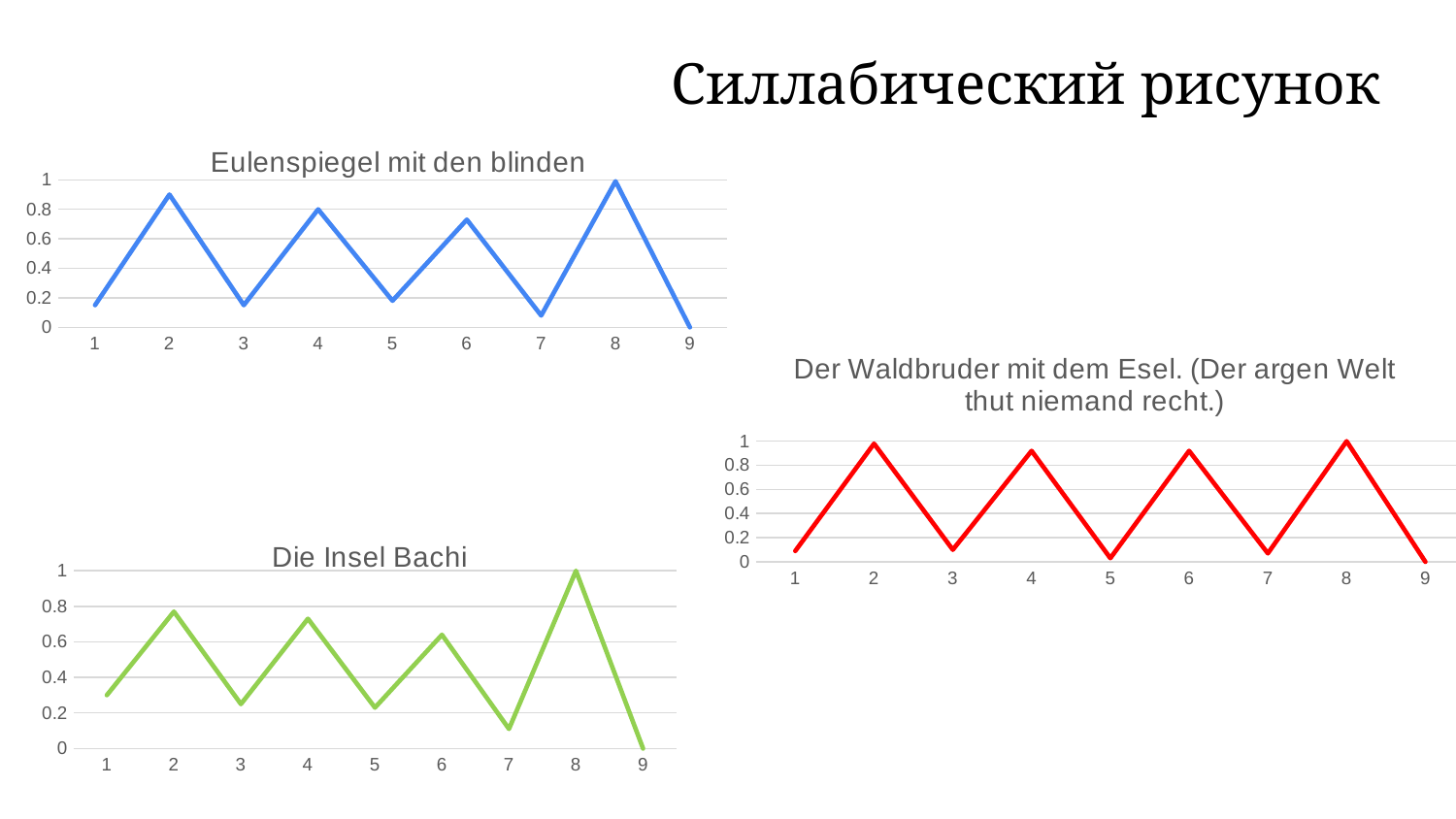
In the "Die Insel Bachi" chart, what is the value at point 8? 1 In the "Die Insel Bachi" chart, which is larger, the value at point 2 or the value at point 6? point 2 In the "Die Insel Bachi" chart, at which x-axis point is the value lowest? 9 In the "Eulenspiegel mit den blinden" chart, at which x-axis point is the value highest? 8 What kind of chart is "Eulenspiegel mit den blinden"? line chart In the "Eulenspiegel mit den blinden" chart, which is larger, the value at point 4 or the value at point 7? point 4 In the "Eulenspiegel mit den blinden" chart, is the value at point 2 greater or less than 0.8? greater What colour is the line in the "Der Waldbruder mit dem Esel" chart? red In the "Die Insel Bachi" chart, is the value at point 7 greater or less than 0.2? less How many points are plotted on the x axis of the "Die Insel Bachi" chart? 9 In the "Der Waldbruder mit dem Esel" chart, what is the value at point 9? 0 In the "Der Waldbruder mit dem Esel" chart, is the value at point 5 greater or less than 0.2? less